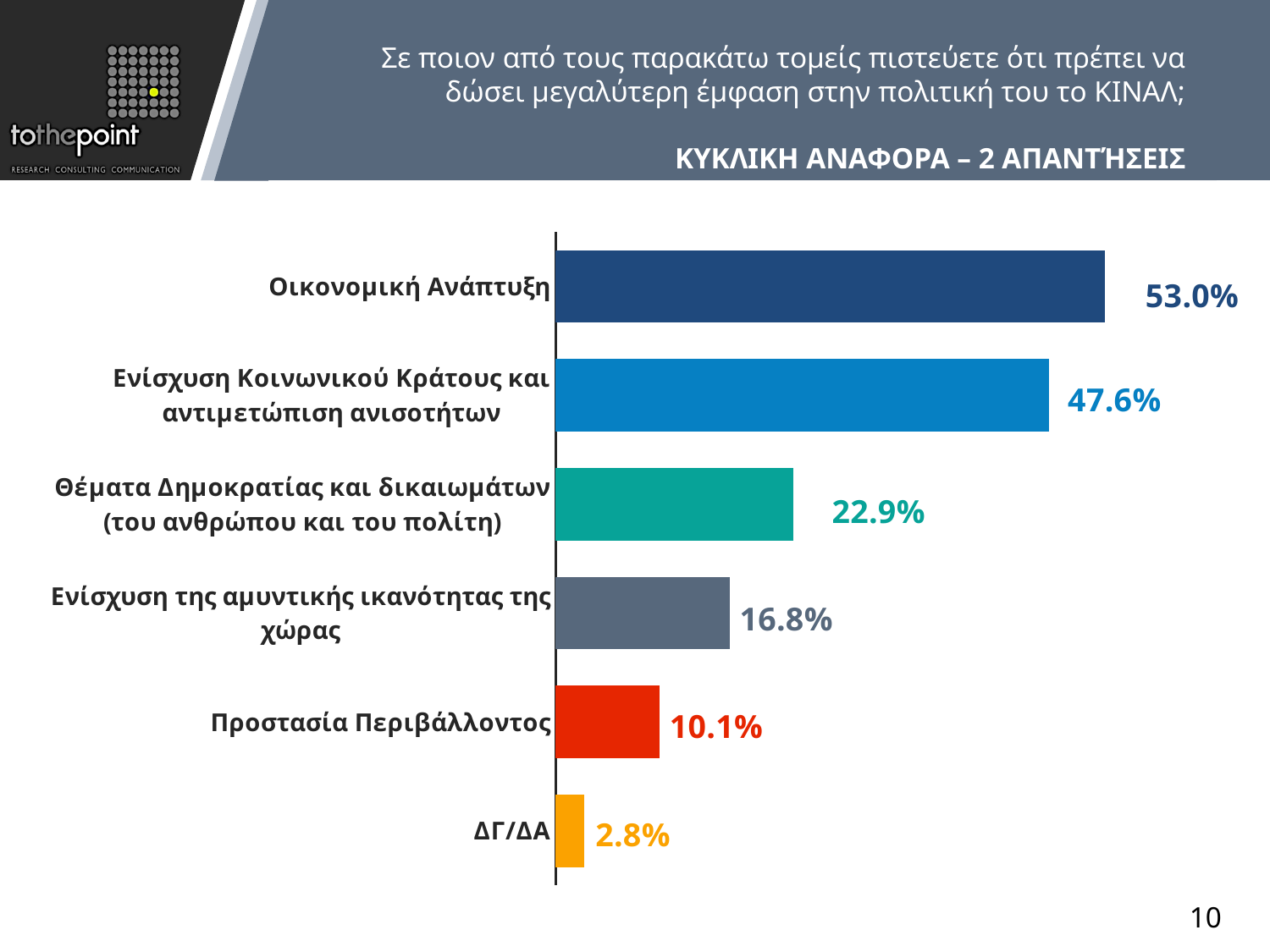
What is the difference between the values for Θέματα Δημοκρατίας και δικαιωμάτων (του ανθρώπου και του πολίτη) and Ενίσχυση της αμυντικής ικανότητας της χώρας? 6.1% What is the value for Θέματα Δημοκρατίας και δικαιωμάτων (του ανθρώπου και του πολίτη)? 22.9% Which category has the lowest value? ΔΓ/ΔΑ What is the value for ΔΓ/ΔΑ? 2.8% What is the difference between the values for Οικονομική Ανάπτυξη and Ενίσχυση Κοινωνικού Κράτους και αντιμετώπιση ανισοτήτων? 5.4% Which category has the highest value? Οικονομική Ανάπτυξη What is the value for Οικονομική Ανάπτυξη? 53.0% How many categories are shown in the chart? 6 Which is larger: the value for Ενίσχυση της αμυντικής ικανότητας της χώρας or the value for Προστασία Περιβάλλοντος? Ενίσχυση της αμυντικής ικανότητας της χώρας What is the value for Ενίσχυση Κοινωνικού Κράτους και αντιμετώπιση ανισοτήτων? 47.6% What kind of chart is shown on the slide? Bar chart What is the value for Προστασία Περιβάλλοντος? 10.1%